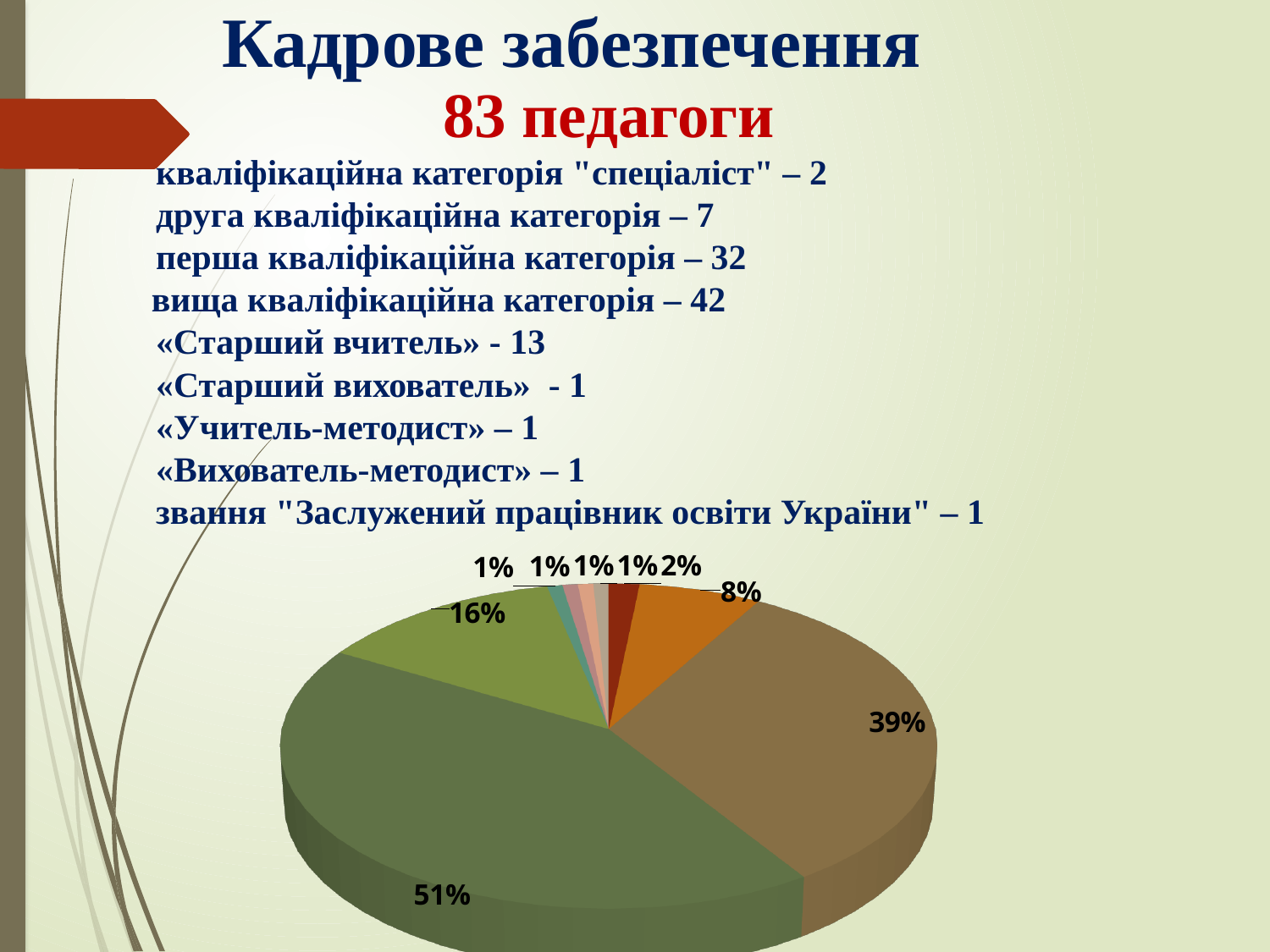
Which is larger on the pie chart, the slice labelled 16% or the slice labelled 8%? 16% What is the smallest percentage labelled on the pie chart? 1% What kind of chart is shown on the slide? pie chart What is the difference between the two largest slices of the pie chart (51% and 39%)? 12% What is the combined share of the two largest slices of the pie chart (51% and 39%)? 90% What is the second-largest percentage labelled on the pie chart? 39% How many slices of the pie chart are labelled 1%? 4 Does the largest slice of the pie chart account for more or less than half of the pie? more How many slices does the pie chart have? 9 What is the largest percentage labelled on the pie chart? 51% What colour is the largest (51%) slice of the pie chart? green Does the pie chart display a legend? No